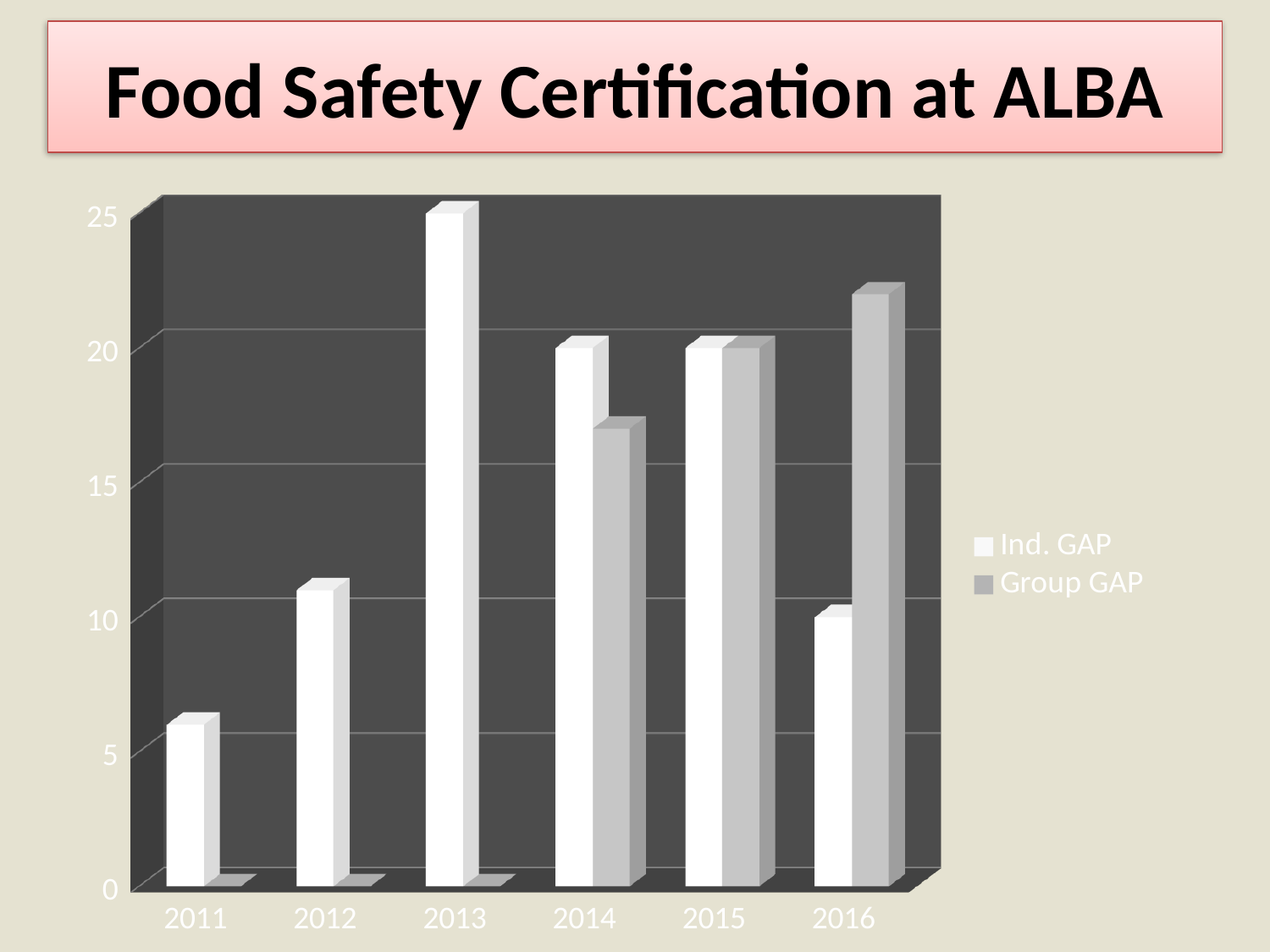
Does the Ind. GAP value rise or fall from 2011 to 2013? rise How many years are shown on the x axis? 6 What kind of chart is shown on the slide? bar chart Is the Group GAP value for 2016 greater or less than 20? greater In which year is the Group GAP value highest? 2016 In 2016, which is larger, Ind. GAP or Group GAP? Group GAP In which year is the Ind. GAP value lowest? 2011 Is the Ind. GAP value for 2011 greater or less than 10? less Is the Group GAP value for 2014 greater or less than 20? less In which year is the Ind. GAP value highest? 2013 How many series does the legend list? 2